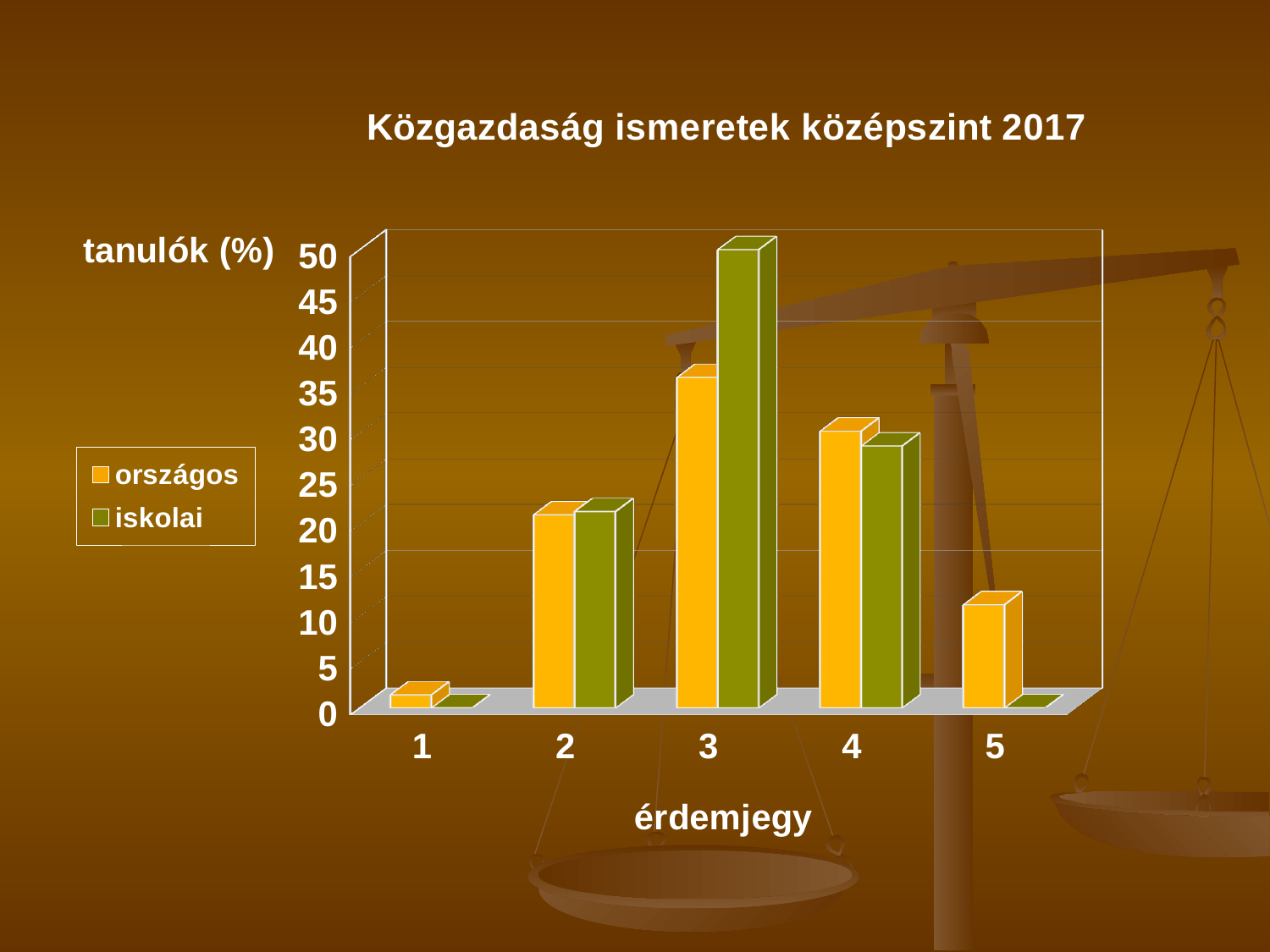
Is the iskolai value for érdemjegy 3 greater or less than 45? greater How many categories (érdemjegy values) are shown on the x axis? 5 For the iskolai series, which érdemjegy has the highest value? 3 Is the országos value for érdemjegy 5 greater or less than 15? less For érdemjegy 3, which series has the larger value, országos or iskolai? iskolai For the országos series, which érdemjegy has the highest value? 3 For the országos series, which érdemjegy has the lowest value? 1 Is the országos value for érdemjegy 3 greater or less than 30? greater For érdemjegy 5, which series has the larger value, országos or iskolai? országos How many series does the legend list? 2 What kind of chart is shown on the slide? bar chart What is the title of the chart? Közgazdaság ismeretek középszint 2017